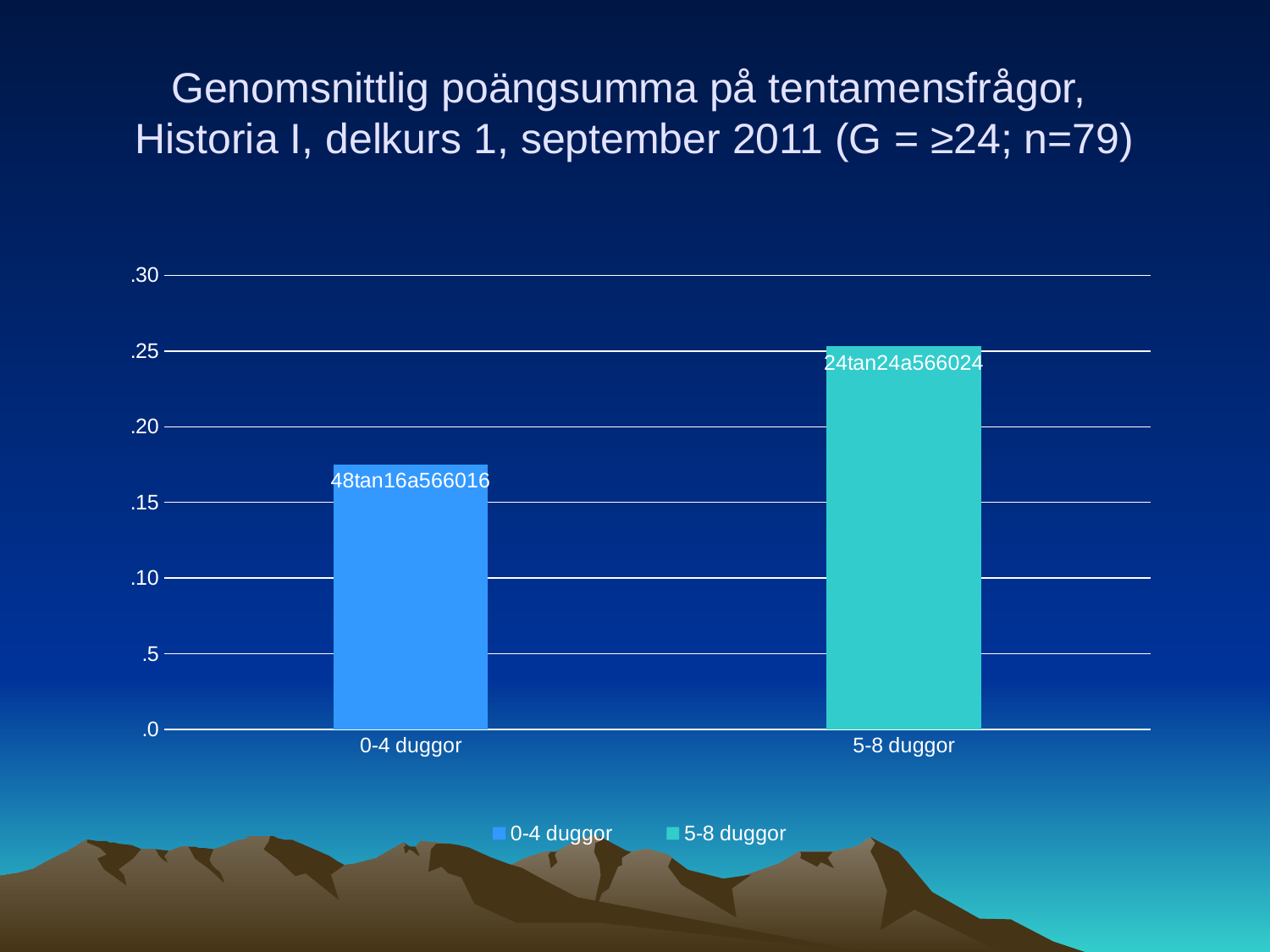
How many categories are plotted on the x axis? 2 What is the highest tick value shown on the y axis? .30 Is the value for 5-8 duggor greater or less than .30? less Which bar is taller, 0-4 duggor or 5-8 duggor? 5-8 duggor Is the value for 0-4 duggor greater or less than .15? greater Is the value for 0-4 duggor greater or less than .20? less How many entries does the legend list? 2 What kind of chart is shown on the slide? bar chart Which category has the lowest bar? 0-4 duggor What are the two category labels on the x axis? 0-4 duggor and 5-8 duggor Which category has the highest bar? 5-8 duggor